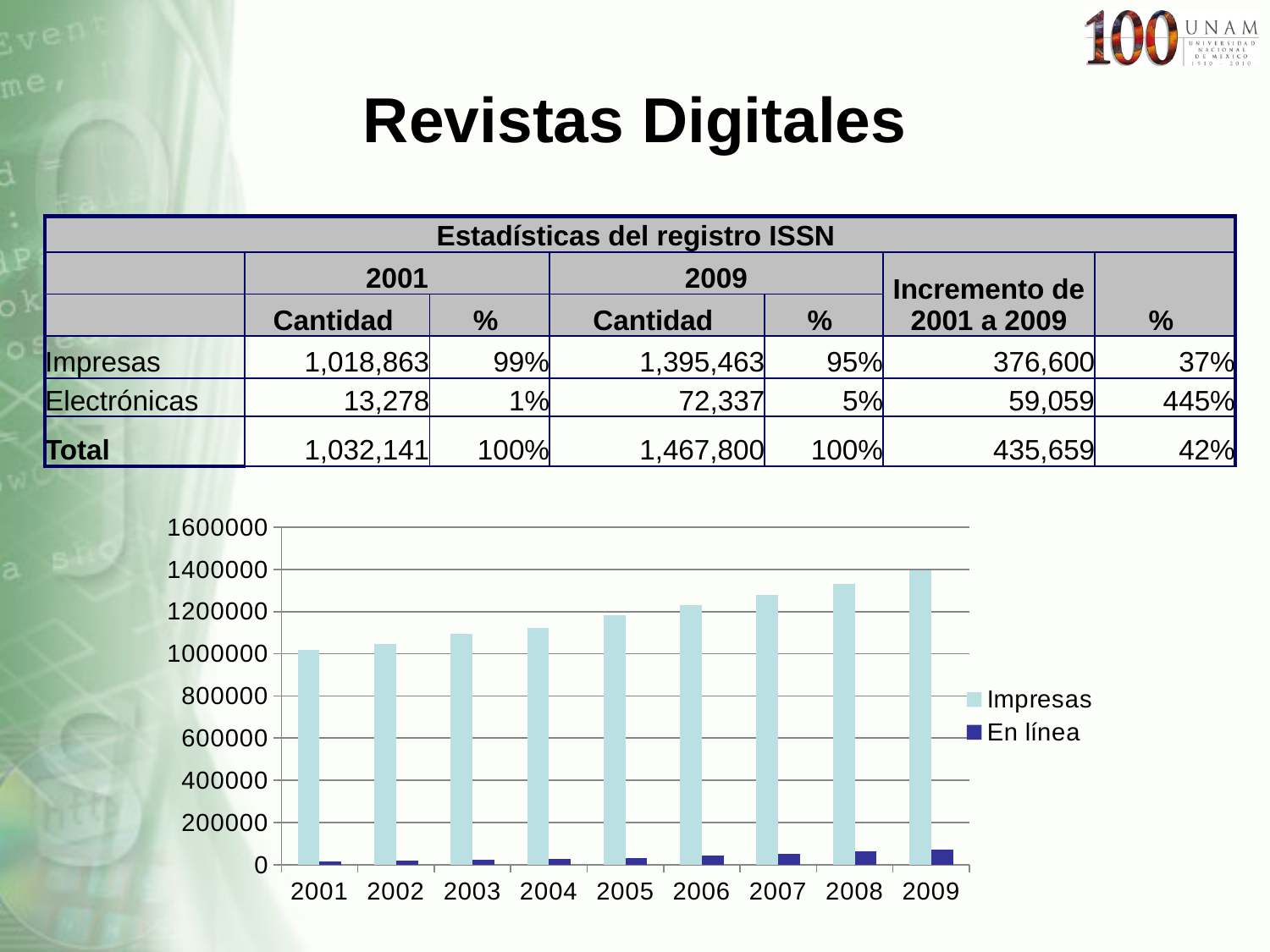
Is the Impresas value for 2009 greater or less than 1200000? greater What kind of chart is shown on the slide? bar chart Do the Impresas values rise or fall from 2001 to 2009? rise What are the two series named in the chart's legend? Impresas and En línea Which series has the larger value in 2005, Impresas or En línea? Impresas In which year is the Impresas bar the shortest? 2001 Is the Impresas value for 2003 greater or less than 1200000? less Which year has the larger Impresas value, 2001 or 2009? 2009 Is the En línea value for 2009 greater or less than 200000? less How many series does the chart's legend list? 2 In which year is the Impresas bar the tallest? 2009 How many years are shown on the x axis of the chart? 9